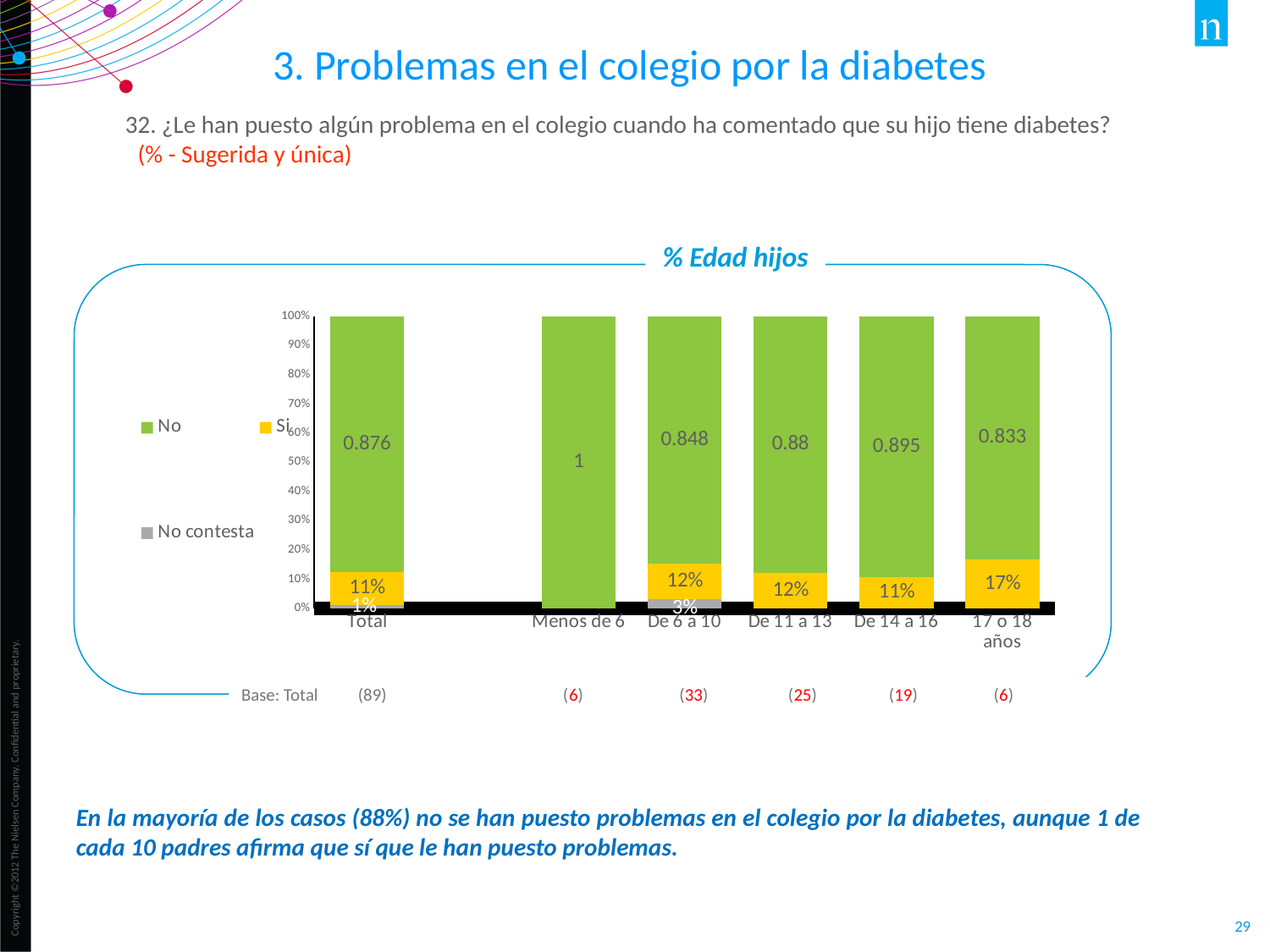
What is the 'No' value for the 'De 14 a 16' category? 0.895 What is the value of the 'No' series for the 'Total' category? 0.876 Is the 'No' value for 'De 6 a 10' greater or less than 50%? greater How many series does the chart legend list? 3 What is the difference between the 'Si' value for '17 o 18 años' and the 'Si' value for 'Total'? 6 percentage points What kind of chart is shown on the slide? Stacked bar chart What is the 'No contesta' value for the 'De 6 a 10' category? 3% Which has a larger 'Si' value: 'De 14 a 16' or '17 o 18 años'? 17 o 18 años Which category has the lowest 'No' value? 17 o 18 años Which category has the highest 'Si' value? 17 o 18 años What is the 'Si' value for the '17 o 18 años' category? 17% How many categories are shown on the x axis of the chart? 6